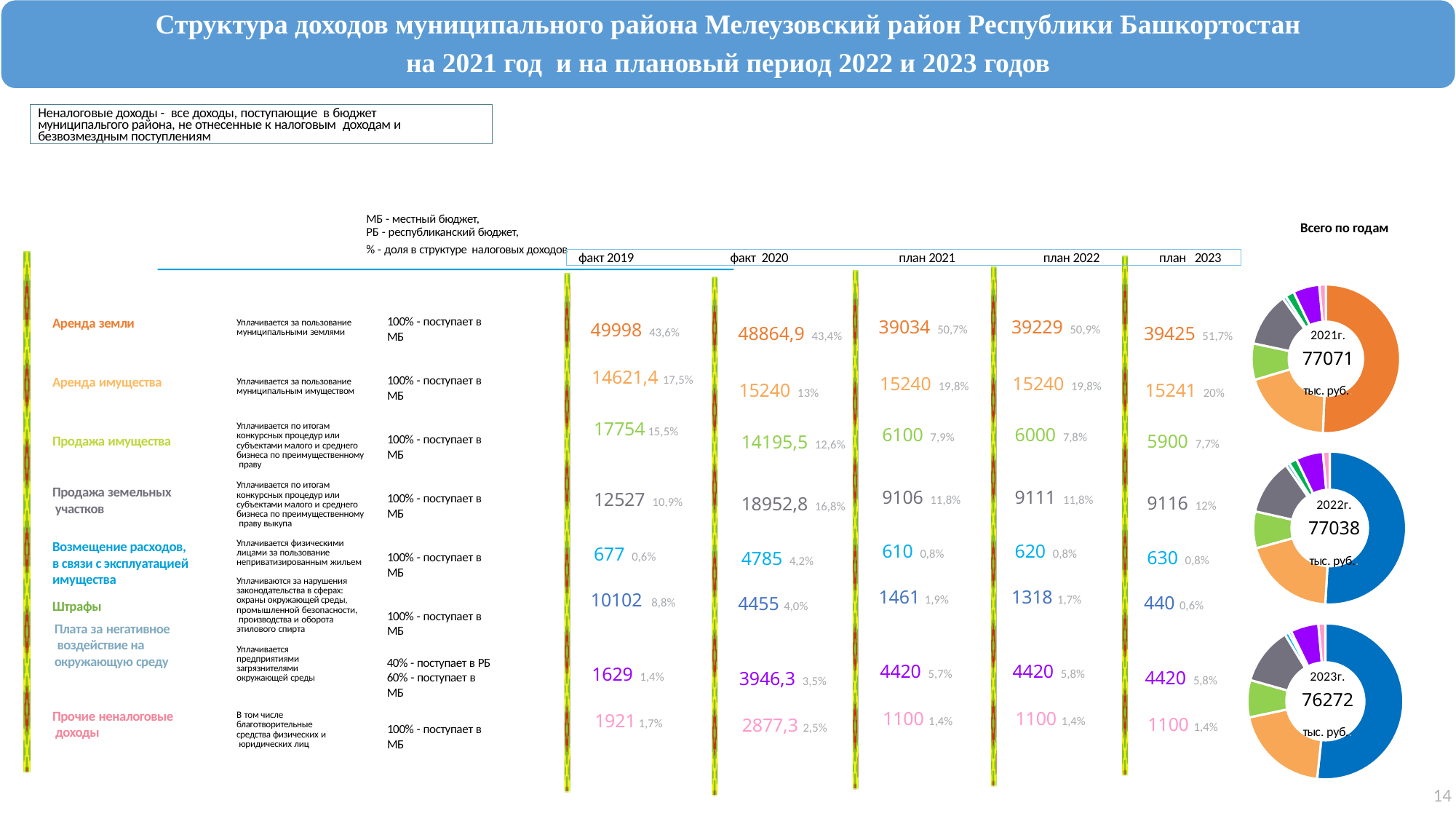
How many donut charts are shown on the right side of the slide? 3 In what units are the totals in the donut charts expressed? тыс. руб. Which total is larger: the one in the 2021г. donut chart or the one in the 2022г. donut chart? 2021г. In the 2023г. donut chart, what total value is shown in the centre? 76272 What heading appears above the donut charts on the right of the slide? Всего по годам In the 2022г. donut chart, what total value is shown in the centre? 77038 What kind of chart is used for the 'Всего по годам' charts on the right of the slide? pie (donut) chart Among the three donut charts, which year has the lowest total? 2023г. In the 2021г. donut chart, what total value is shown in the centre? 77071 What is the difference between the totals shown in the 2022г. and 2023г. donut charts? 766 What is the difference between the totals shown in the 2021г. and 2023г. donut charts? 799 Among the three donut charts, which year has the highest total? 2021г.